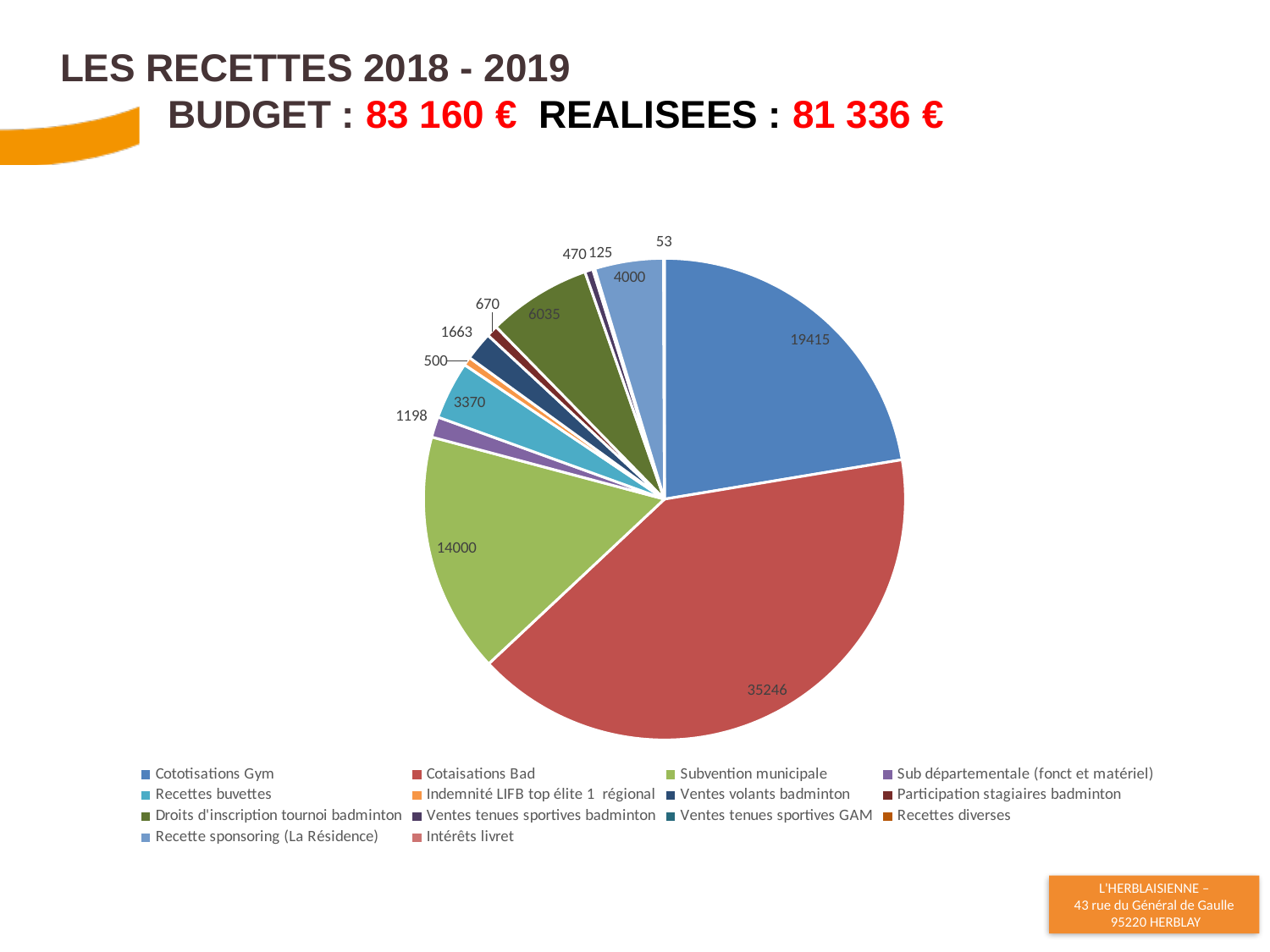
What is the difference between the Cotaisations Bad value and the Cotisations Gym value? 15831 What is the REALISEES amount shown in the slide title? 81 336 € What is the smallest value labelled on the pie chart? 53 What is the value of the Cotisations Gym slice? 19415 What is the value of the Cotaisations Bad slice? 35246 How many entries does the legend list? 14 Which category has the largest slice of the pie? Cotaisations Bad What is the value of the Recette sponsoring (La Résidence) slice? 4000 What kind of chart is shown on the slide? pie chart What is the value of the Droits d'inscription tournoi badminton slice? 6035 Which is larger, Subvention municipale or Recettes buvettes? Subvention municipale What is the value of the Subvention municipale slice? 14000